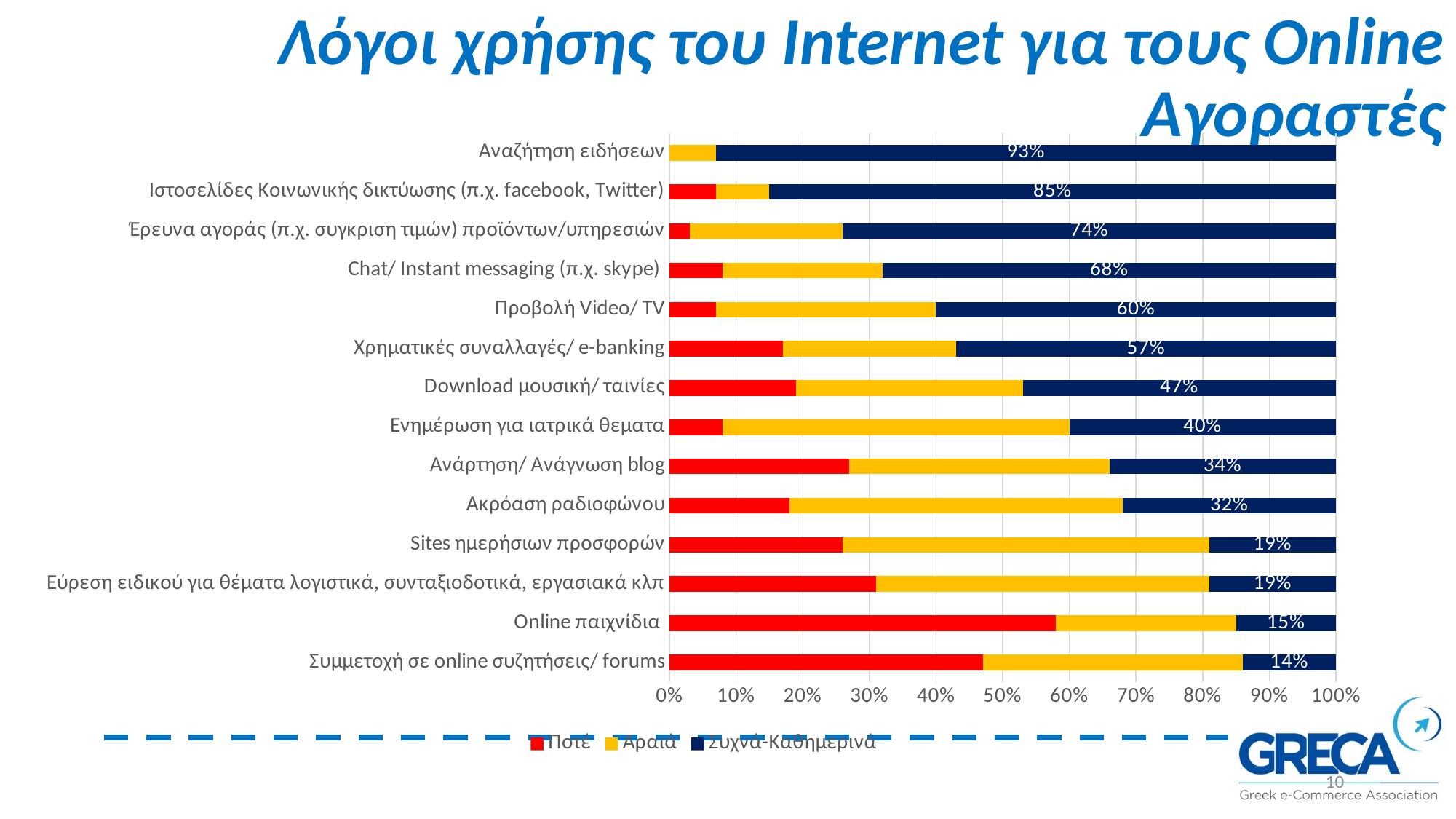
What is the 'Συχνά-Καθημερινά' value for 'Online παιχνίδια'? 15% Which series is shown in red in the chart? Ποτέ What is the difference between the 'Συχνά-Καθημερινά' values for 'Ιστοσελίδες Κοινωνικής δικτύωσης (π.χ. facebook, Twitter)' and 'Προβολή Video/ TV'? 25% How many categories (reasons for using the Internet) are plotted on the chart? 14 How many series does the legend list? 3 What kind of chart is shown on the slide? Stacked bar chart Which category has the lowest 'Συχνά-Καθημερινά' value? Συμμετοχή σε online συζητήσεις/ forums Which category has the highest 'Συχνά-Καθημερινά' value? Αναζήτηση ειδήσεων What is the 'Συχνά-Καθημερινά' value for 'Χρηματικές συναλλαγές/ e-banking'? 57% Which has a larger 'Συχνά-Καθημερινά' value: 'Download μουσική/ ταινίες' or 'Ακρόαση ραδιοφώνου'? Download μουσική/ ταινίες Is the 'Ποτέ' value for 'Online παιχνίδια' greater or less than 50%? greater What is the 'Συχνά-Καθημερινά' value for 'Αναζήτηση ειδήσεων'? 93%